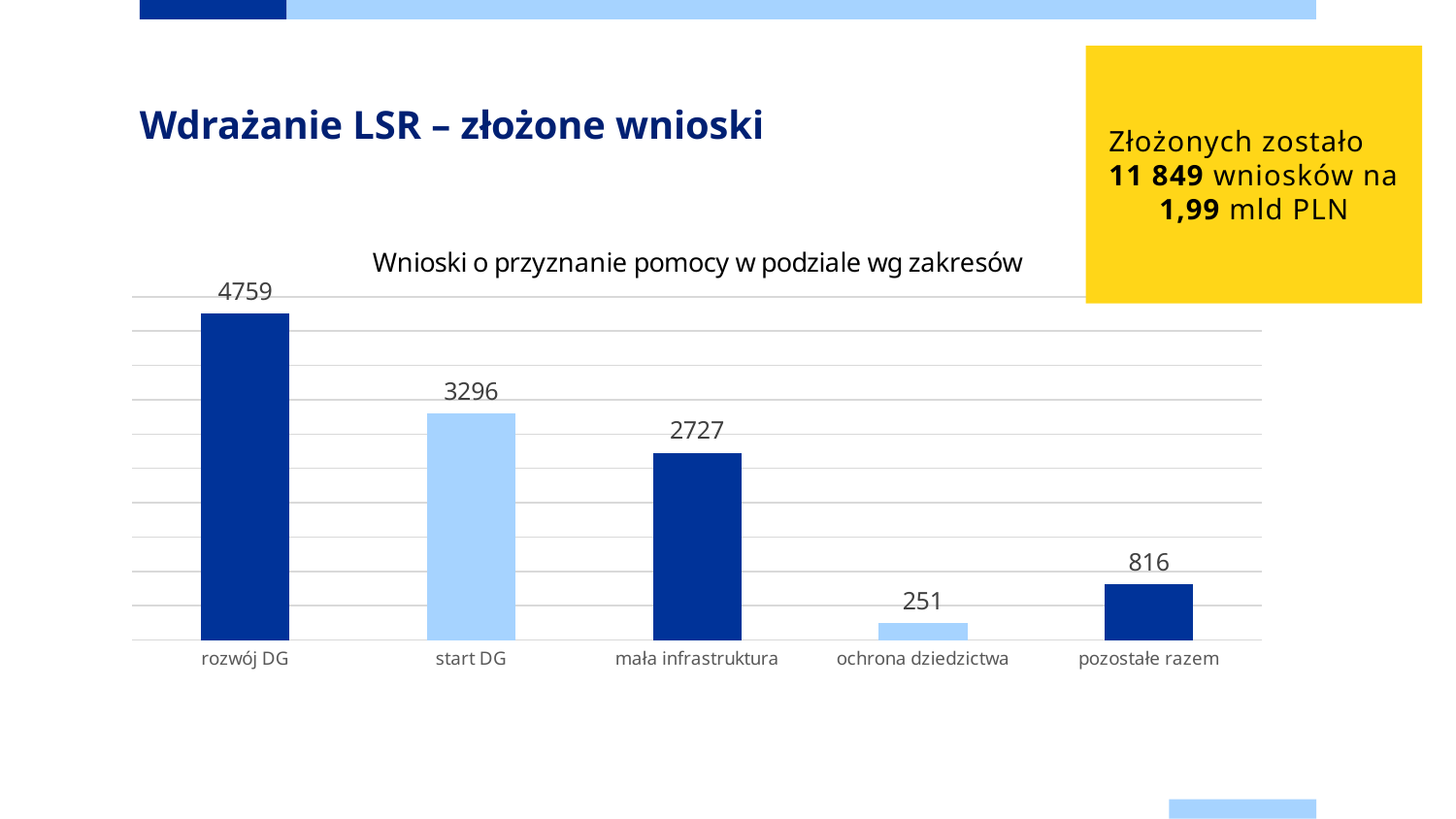
How many categories are shown on the chart? 5 What is the value for rozwój DG? 4759 What is the value for mała infrastruktura? 2727 Which is larger, the value for mała infrastruktura or the value for pozostałe razem? mała infrastruktura What is the value for ochrona dziedzictwa? 251 What kind of chart is shown on the slide? bar chart What is the title of the chart? Wnioski o przyznanie pomocy w podziale wg zakresów What is the value for pozostałe razem? 816 What is the difference between the values for rozwój DG and start DG? 1463 Which category has the lowest value? ochrona dziedzictwa What is the value for start DG? 3296 Which category has the highest value? rozwój DG